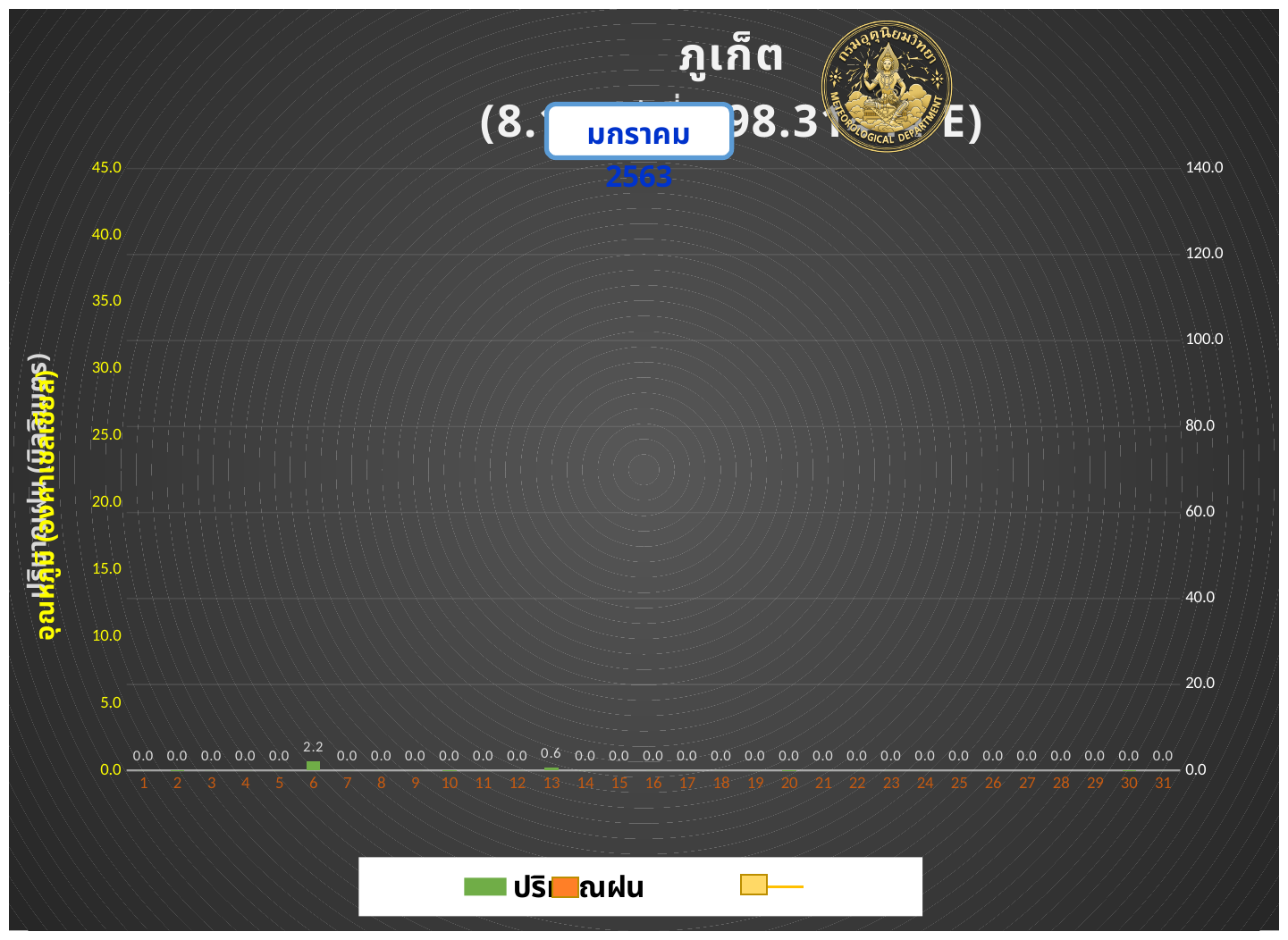
Which day has the highest rainfall value? 6 What is the station name shown in the chart title? ภูเก็ต Is the value for day 6 greater or less than 5.0? less What is the difference between the values for day 6 and day 13? 1.6 Which is larger, the value for day 6 or the value for day 13? day 6 What is the rainfall value labelled for day 13? 0.6 What is the value labelled for day 1? 0.0 What is the rainfall value labelled for day 6? 2.2 What month is shown in the blue box above the chart? มกราคม What is the value labelled for day 20? 0.0 What kind of chart is this? bar chart How many days are shown on the x axis? 31